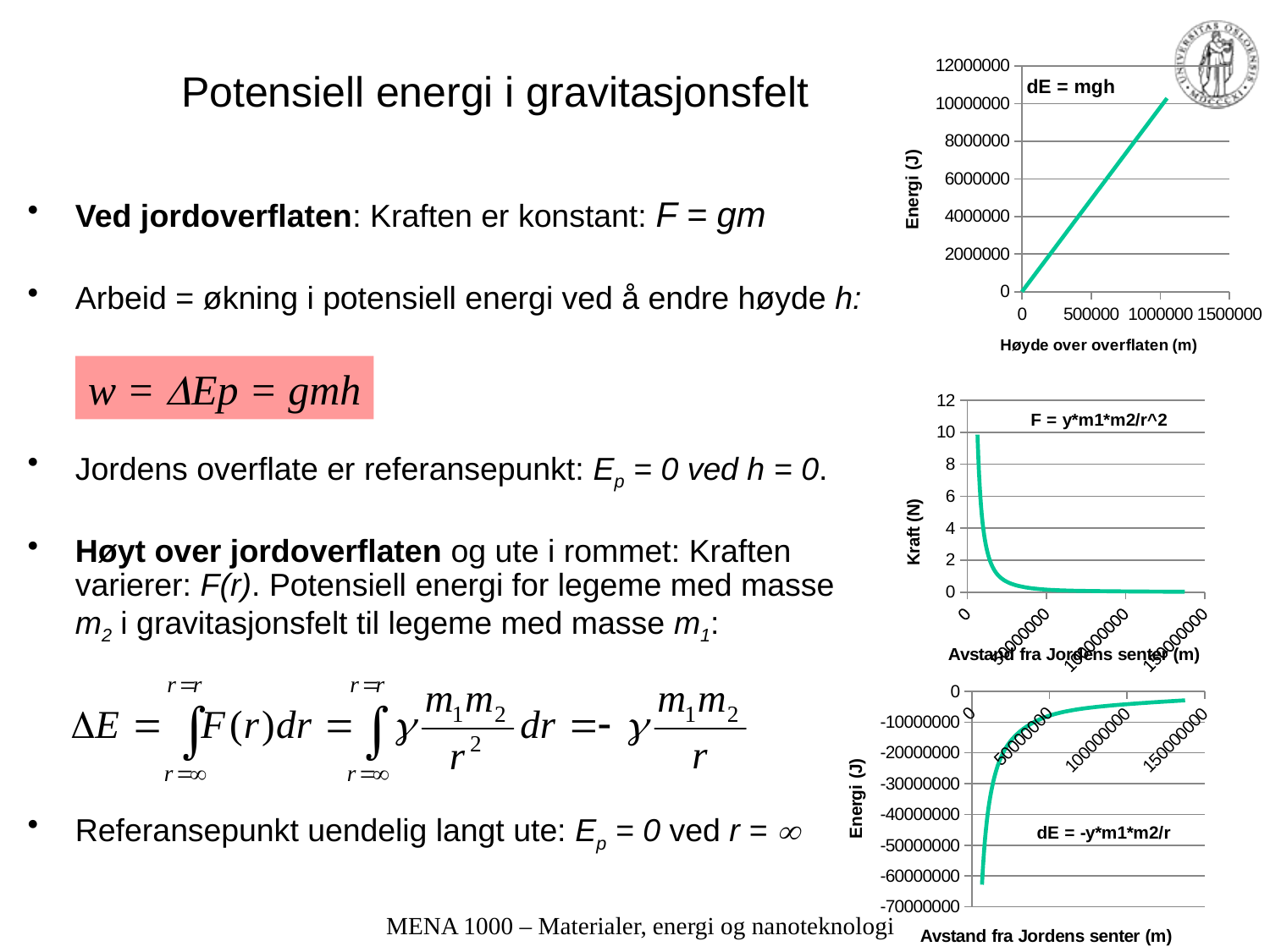
In the bottom chart "dE = -y*m1*m2/r", is the energy at a distance of 100000000 m greater or less than -10000000 J? greater In the top chart "dE = mgh", does the energy rise or fall as the height above the surface increases? rise In the top chart "dE = mgh", is the energy at a height of 500000 m greater or less than 4000000 J? greater In the middle chart "F = y*m1*m2/r^2", does the force rise or fall as the distance from the Earth's centre increases? fall In the bottom chart "dE = -y*m1*m2/r", does the energy rise or fall as the distance from the Earth's centre increases? rise In the middle chart "F = y*m1*m2/r^2", is the force at a distance of 50000000 m greater or less than 2 N? less What is the x-axis title of the top chart "dE = mgh"? Høyde over overflaten (m) What kind of chart is the bottom chart titled "dE = -y*m1*m2/r"? line chart What is the y-axis title of the middle chart "F = y*m1*m2/r^2"? Kraft (N) What kind of chart is the top chart titled "dE = mgh"? line chart